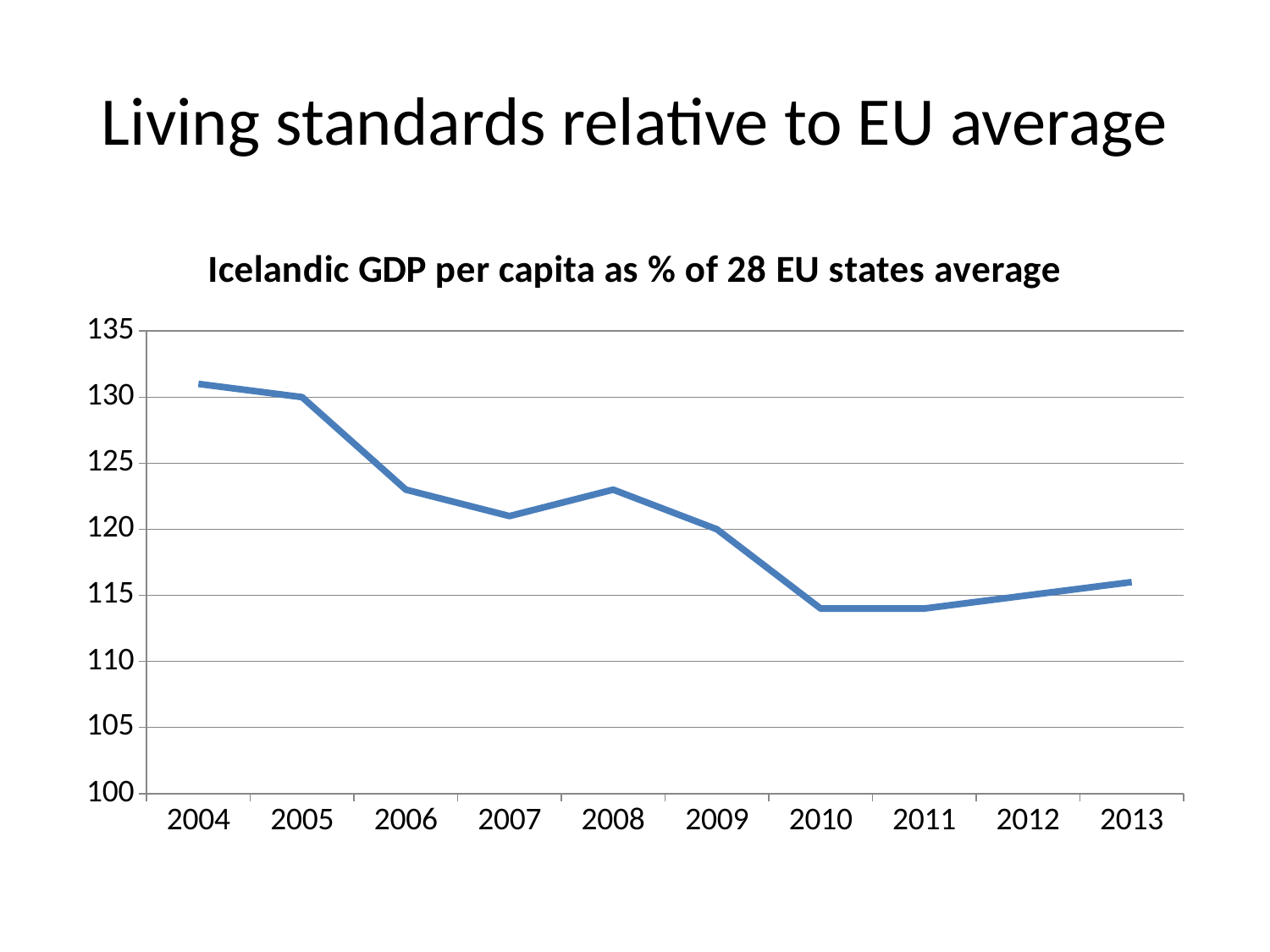
Is the value for 2010 greater or less than 115? less What is the value for 2005? 130 Is the value for 2013 greater or less than 115? greater What is the value for 2009? 120 Overall, do the values rise or fall from 2004 to 2013? fall How many years are plotted on the x axis? 10 Which year has the highest value? 2004 What kind of chart is shown on the slide? Line chart Is the value for 2004 greater or less than 125? greater What is the title of the chart? Icelandic GDP per capita as % of 28 EU states average Which is larger, the value for 2004 or the value for 2013? 2004